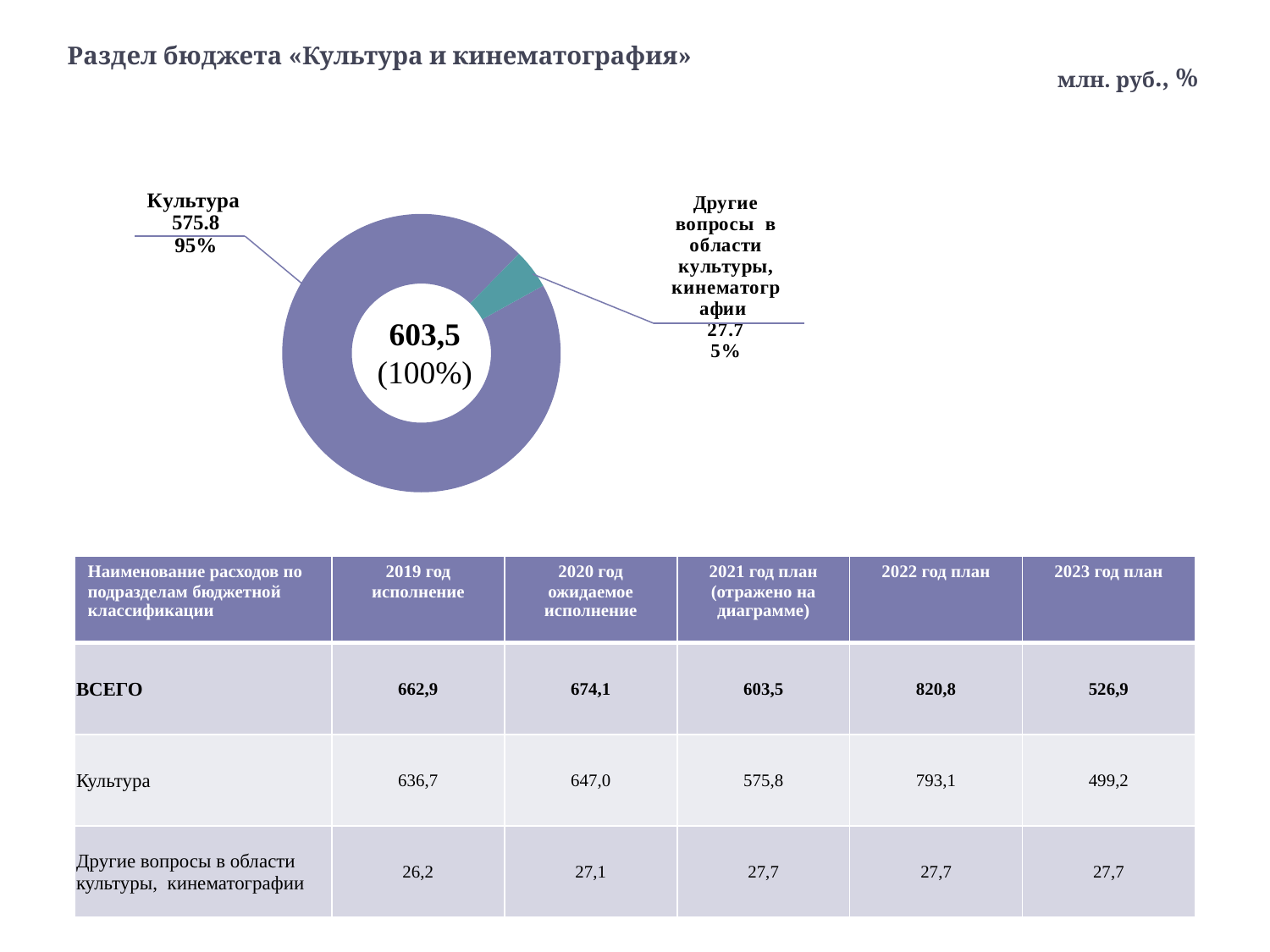
Which slice of the donut chart is the smallest? Другие вопросы в области культуры, кинематографии How many slices does the donut chart have? 2 What is the value shown for the Культура slice in the donut chart? 575.8 Which slice of the donut chart is the largest? Культура What share of the donut chart does the slice «Другие вопросы в области культуры, кинематографии» represent? 5% What is the value shown for the slice «Другие вопросы в области культуры, кинематографии» in the donut chart? 27.7 What kind of chart is shown on the slide? Donut (pie) chart What total value is shown in the centre of the donut chart? 603,5 (100%) What is the difference between the Культура slice and the «Другие вопросы в области культуры, кинематографии» slice in the donut chart? 548.1 Which is larger in the donut chart: Культура or «Другие вопросы в области культуры, кинематографии»? Культура What units are indicated for the chart on the slide? млн. руб., % What share of the donut chart does the Культура slice represent? 95%